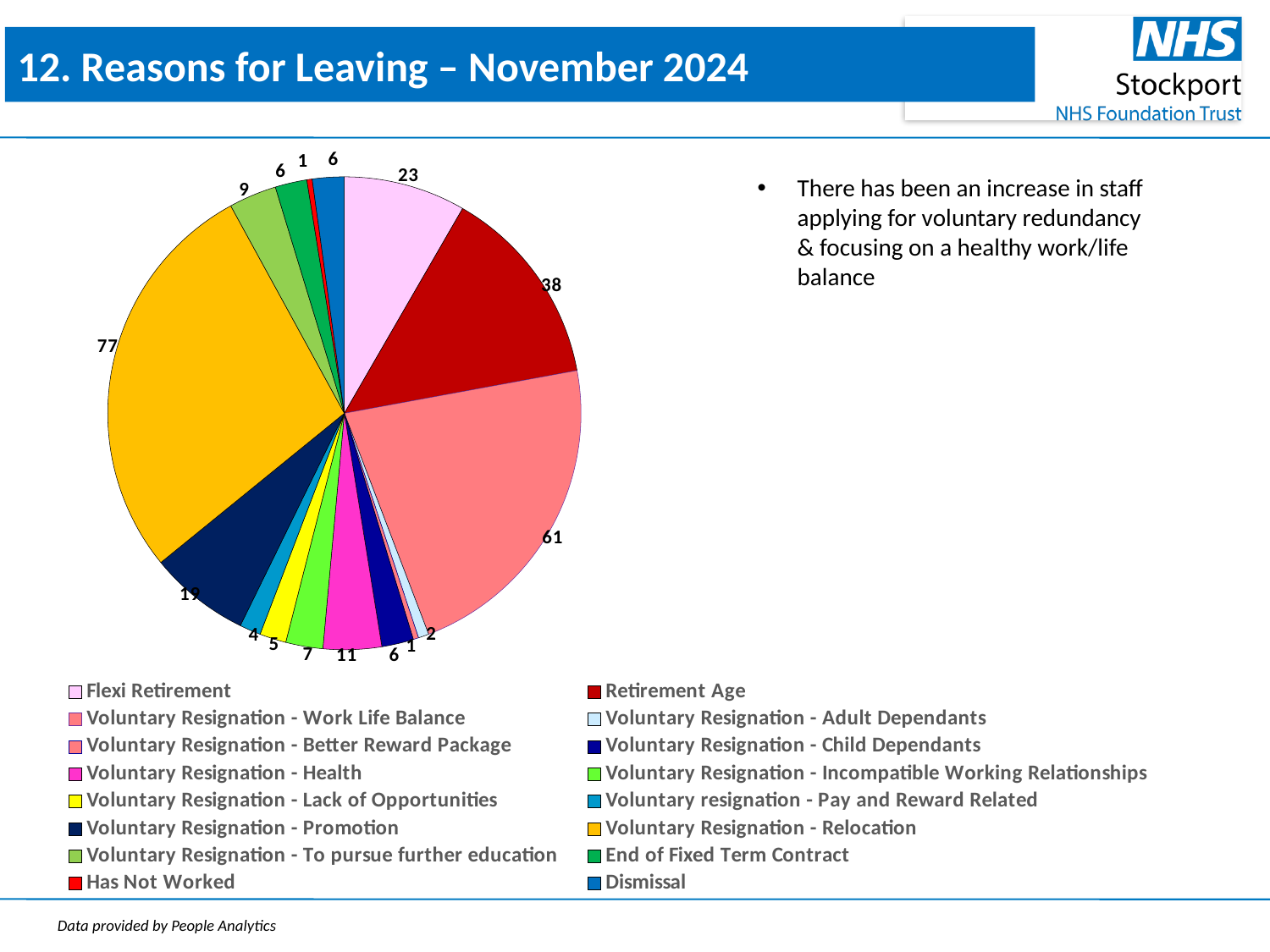
What is the value for Voluntary Resignation - Work Life Balance? 61 What is the title of the slide containing the chart? 12. Reasons for Leaving – November 2024 Which is larger, Retirement Age or Flexi Retirement? Retirement Age What is the value for Voluntary Resignation - Promotion? 19 What is the value for Flexi Retirement? 23 How many entries does the legend list? 16 What type of chart is shown on the slide? pie chart What is the value for Voluntary Resignation - Health? 11 What is the difference between the values for Voluntary Resignation - Relocation and Voluntary Resignation - Work Life Balance? 16 Which reason for leaving has the largest slice? Voluntary Resignation - Relocation What is the value for Voluntary Resignation - Relocation? 77 What is the value for Retirement Age? 38